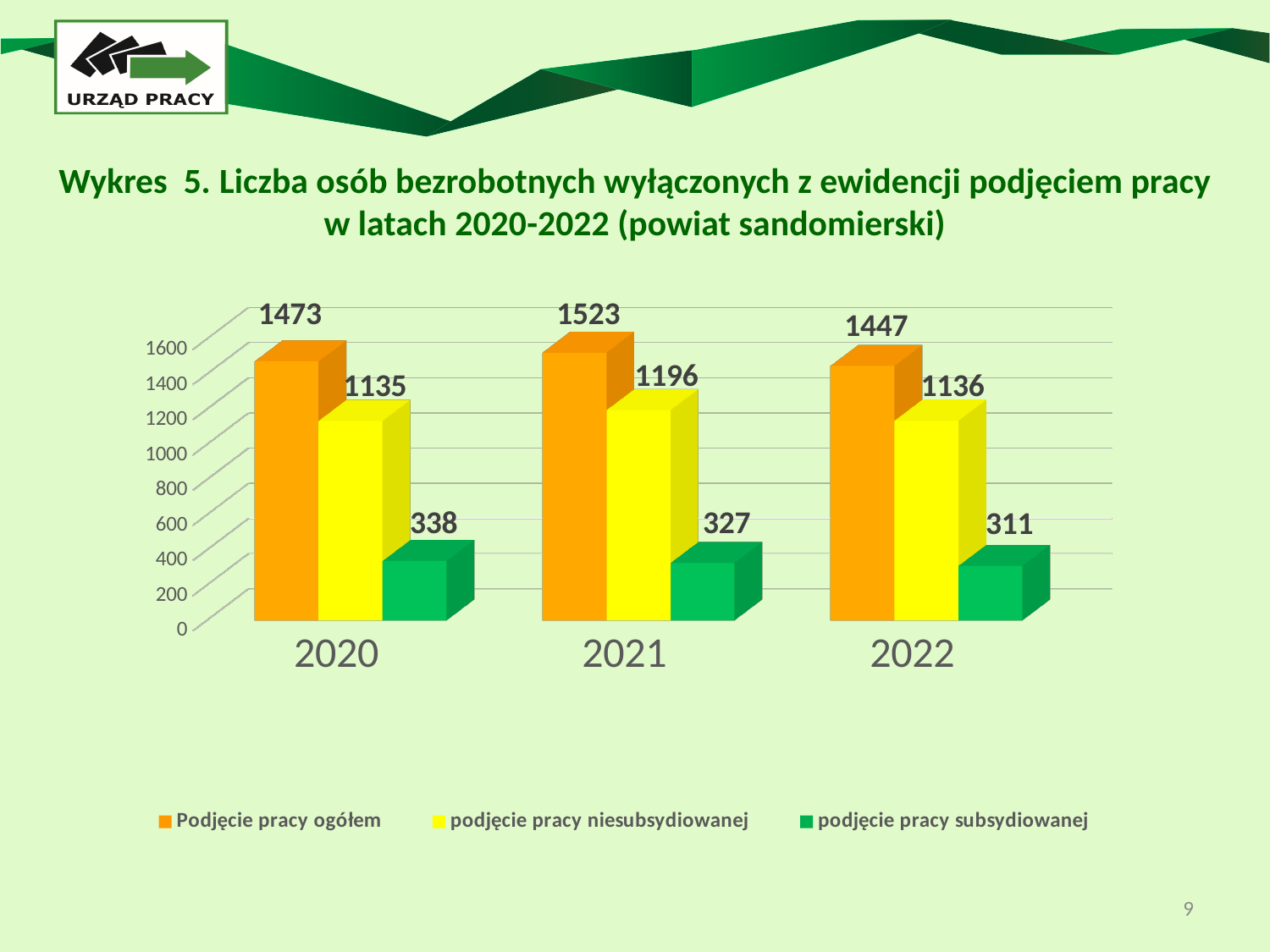
What is the value of 'podjęcie pracy niesubsydiowanej' for 2020? 1135 In which year is 'Podjęcie pracy ogółem' highest? 2021 Which is larger: 'podjęcie pracy niesubsydiowanej' in 2021 or in 2022? 2021 How many series does the legend list? 3 What is the value of 'podjęcie pracy subsydiowanej' for 2022? 311 Which colour represents 'podjęcie pracy subsydiowanej' in the legend? green Is the value for 'podjęcie pracy subsydiowanej' in 2020 greater or less than 400? less How many years are shown on the x axis? 3 In which year is 'podjęcie pracy subsydiowanej' lowest? 2022 What is the value of 'Podjęcie pracy ogółem' for 2021? 1523 What is the difference between 'Podjęcie pracy ogółem' in 2021 and in 2022? 76 What kind of chart is shown on the slide? bar chart